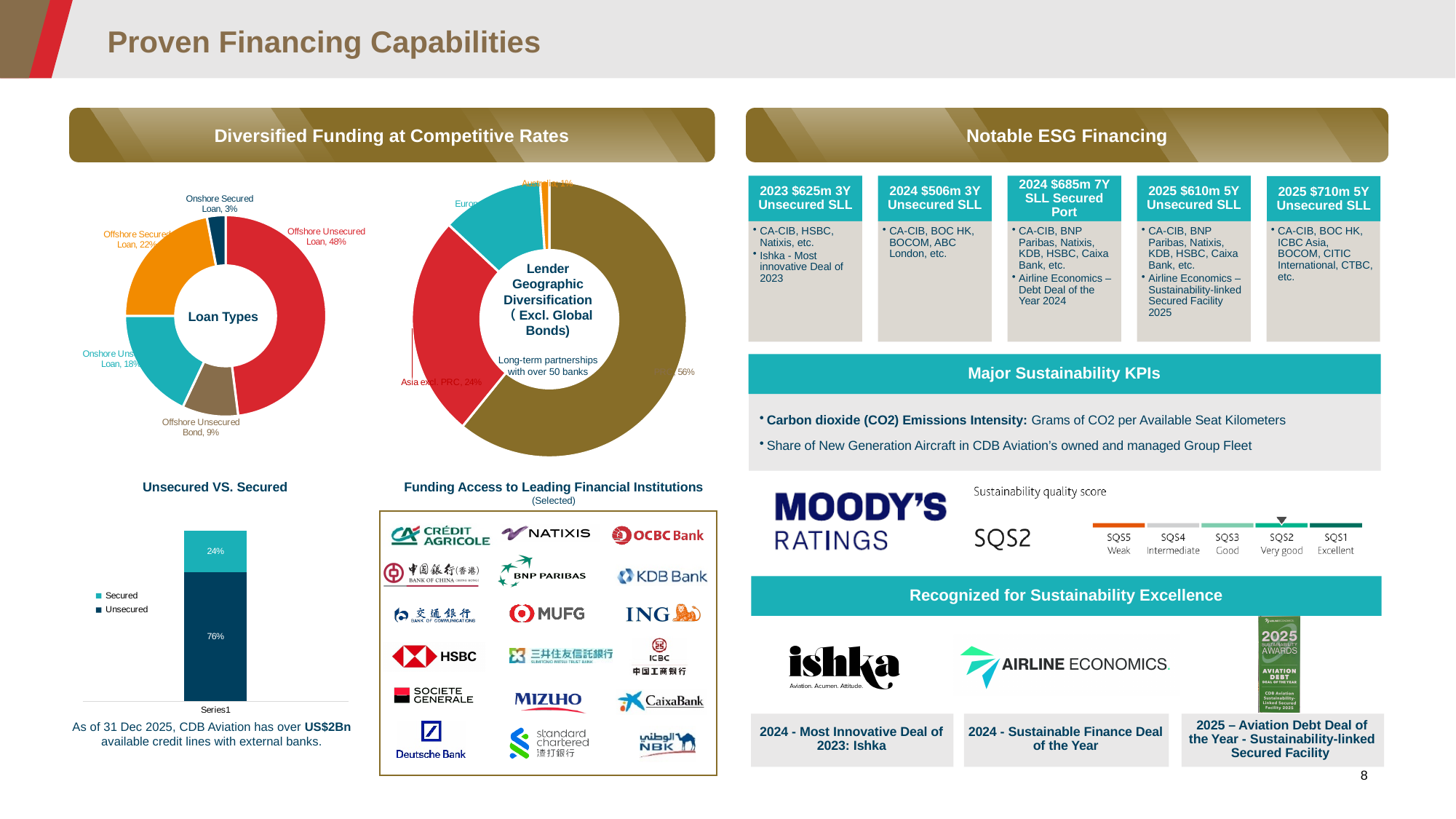
In the Loan Types chart, what is the difference between the Offshore Unsecured Loan share and the Offshore Secured Loan share? 26% In the Loan Types chart, how many loan types are shown? 5 In the Loan Types chart, what share is Offshore Unsecured Bond? 9% In the Lender Geographic Diversification chart, what share is Asia excl. PRC? 24% In the Lender Geographic Diversification chart, what share is Australia? 1% In the Loan Types chart, which loan type has the largest share? Offshore Unsecured Loan In the Loan Types chart, what share is Offshore Secured Loan? 22% In the Unsecured VS. Secured chart, what percentage is Unsecured? 76% In the Unsecured VS. Secured chart, how many series does the legend list? 2 In the Loan Types chart, which loan type has the smallest share? Onshore Secured Loan In the Loan Types chart, what share is Offshore Unsecured Loan? 48% In the Lender Geographic Diversification chart, which is larger, Asia excl. PRC or Australia? Asia excl. PRC